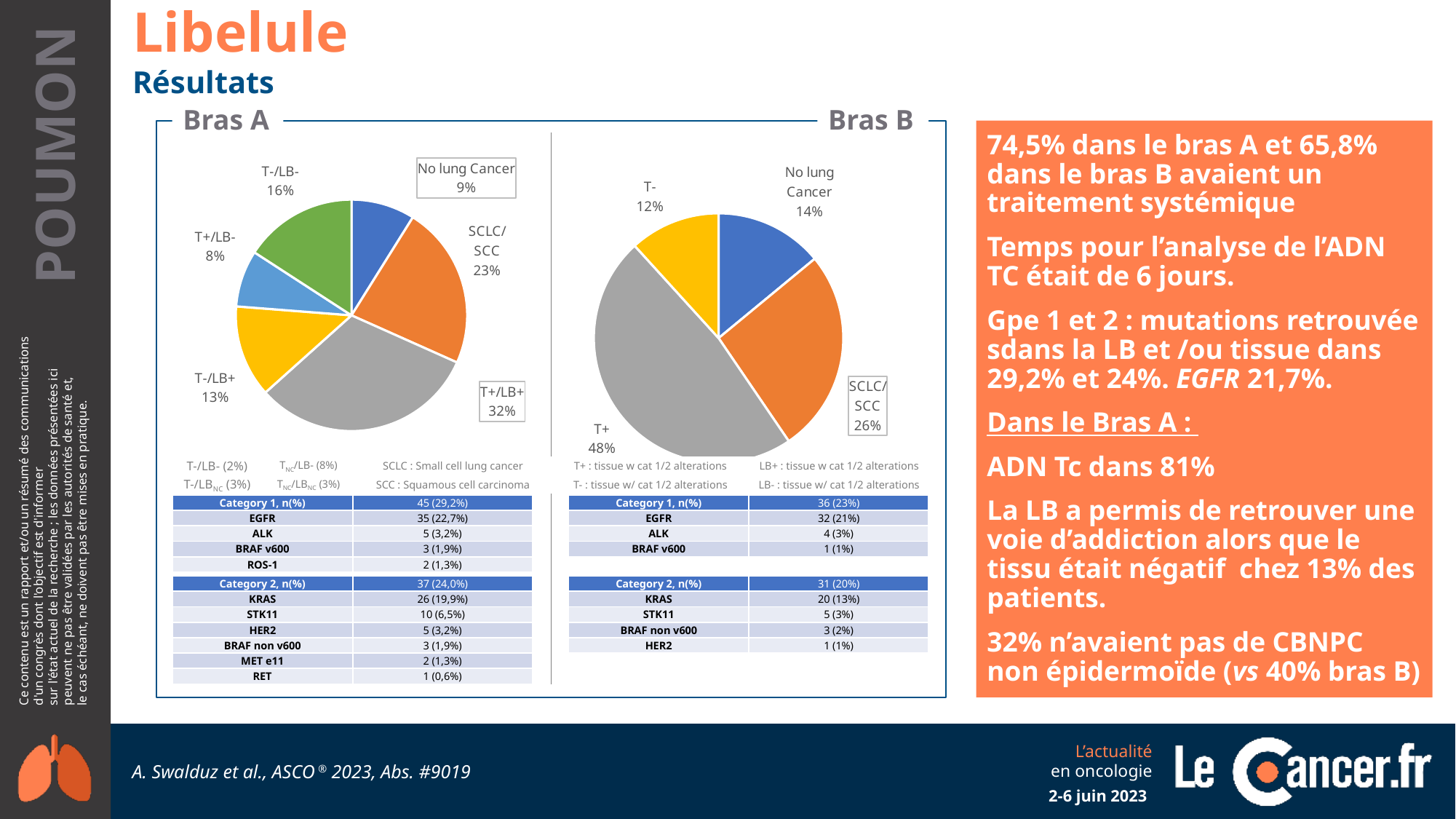
In the Bras A pie chart, how many slices are there? 6 In the Bras B pie chart, what share is labelled for T+? 48% In the Bras A pie chart, what share is labelled for T+/LB+? 32% In the Bras B pie chart, how many slices are there? 4 In the Bras B pie chart, which slice is the smallest? T- In the Bras A pie chart, which slice is the largest? T+/LB+ In the Bras A pie chart, which slice is the smallest? T+/LB- In the Bras B pie chart, what share is labelled for SCLC/SCC? 26% In the Bras A pie chart, what is the difference between the SCLC/SCC share and the T-/LB+ share? 10% What type of chart is used for Bras A and Bras B? Pie chart In the Bras A pie chart, what share is labelled for No lung Cancer? 9% In the Bras A pie chart, what share is labelled for T-/LB-? 16%